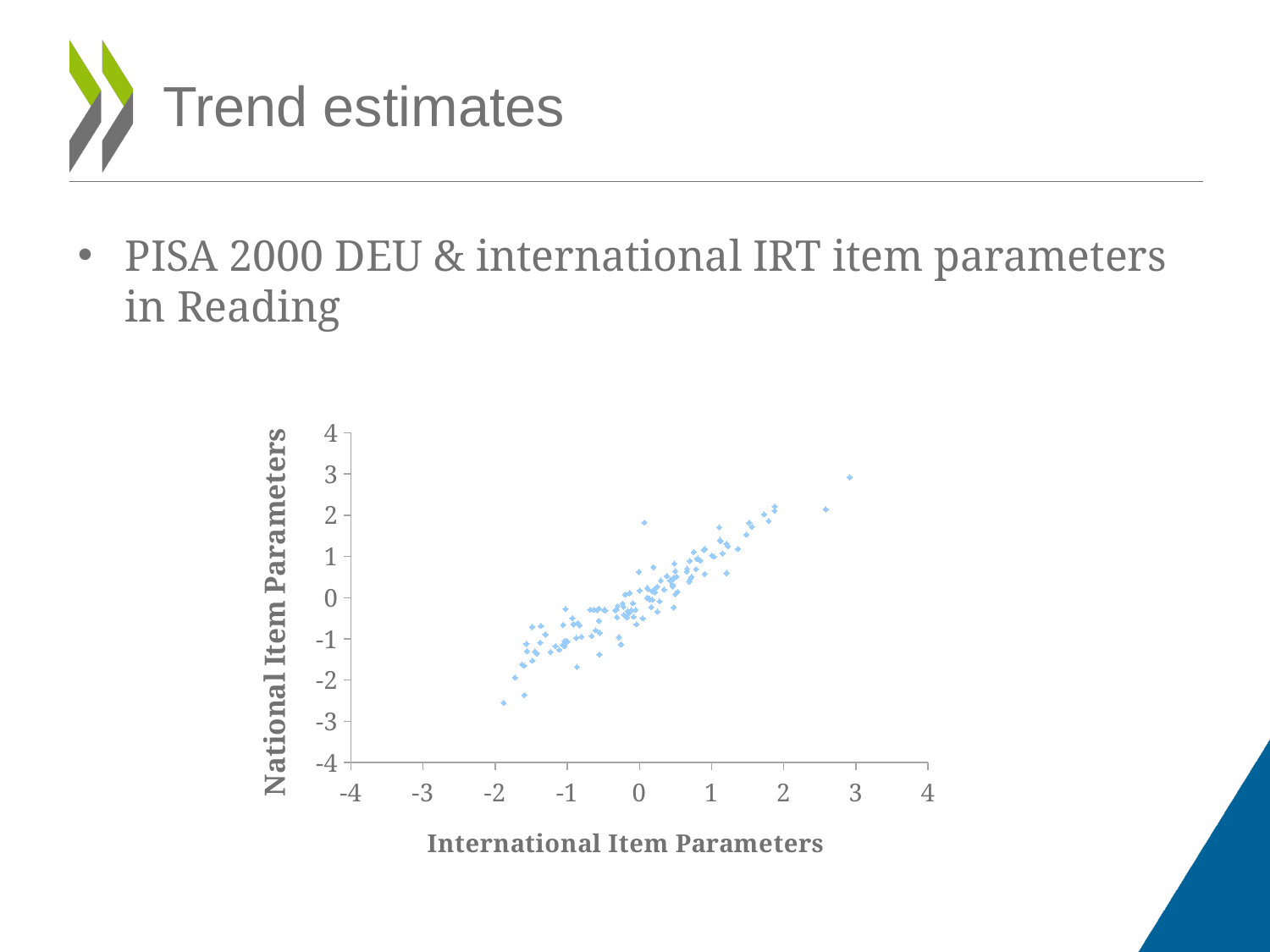
Is the highest national item parameter plotted on the chart greater or less than 2? greater Is the largest international item parameter plotted on the chart greater or less than 2? greater What kind of chart is shown on the slide? scatter plot What is the minimum value shown on the x axis of the chart? -4 What is the title of the x axis of the chart? International Item Parameters What is the maximum value shown on the y axis of the chart? 4 As the international item parameters increase along the x axis, do the national item parameters generally rise or fall? rise Is the smallest international item parameter plotted on the chart greater or less than -1? less